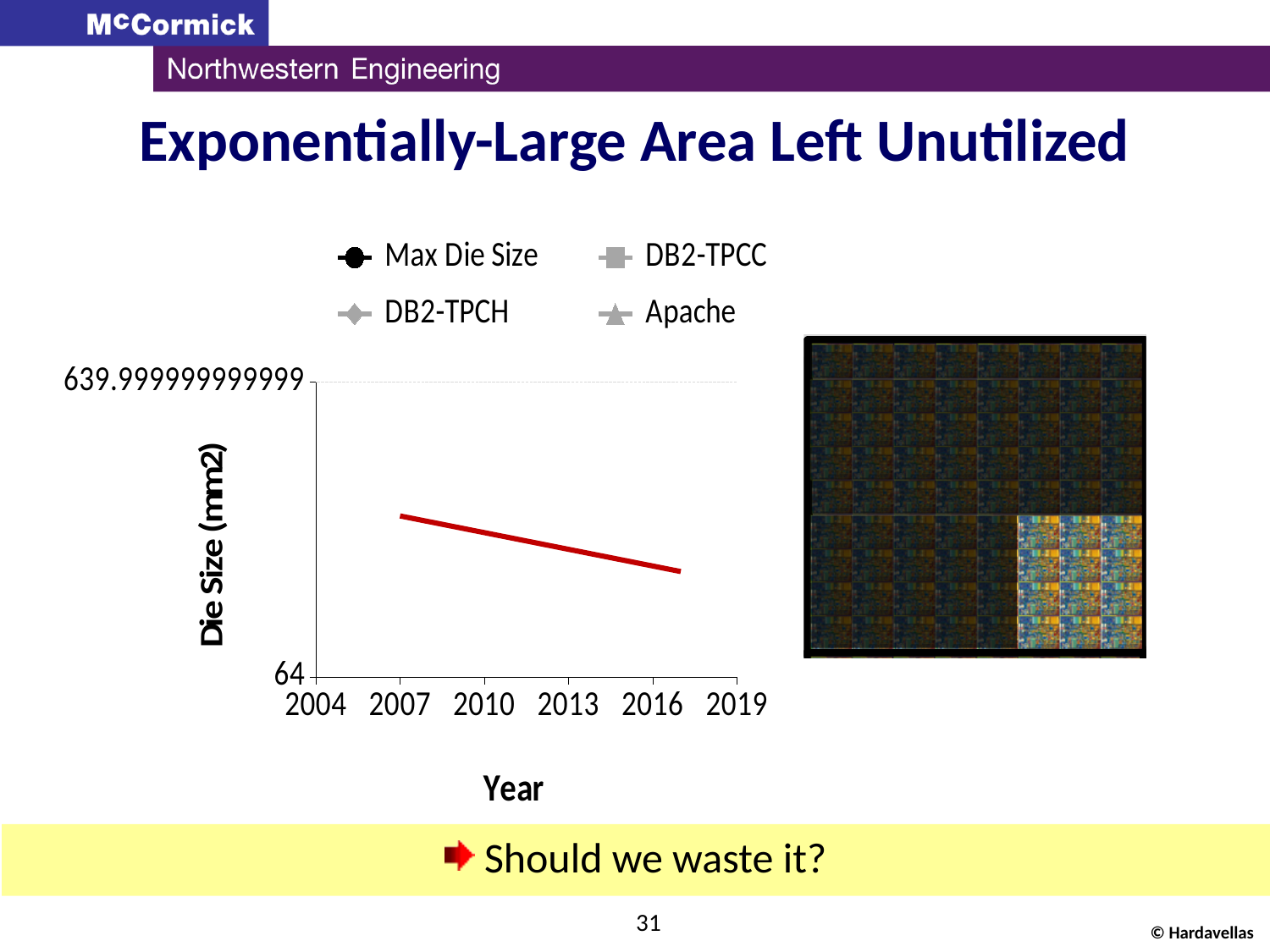
What is the label of the chart's y axis? Die Size (mm2) What is the last year labelled on the chart's x axis? 2019 What is the label of the chart's x axis? Year How many year tick labels are shown on the chart's x axis? 6 Does the red line in the chart rise or fall as the year increases? fall How many series does the chart's legend list? 4 What kind of chart is shown on the slide? line chart Which legend entry is shown with a black circle marker? Max Die Size What is the first year labelled on the chart's x axis? 2004 What is the highest value labelled on the chart's y axis? 639.999999999999 What is the lowest value labelled on the chart's y axis? 64 Is the value of the red line at 2007 greater or less than 64? greater